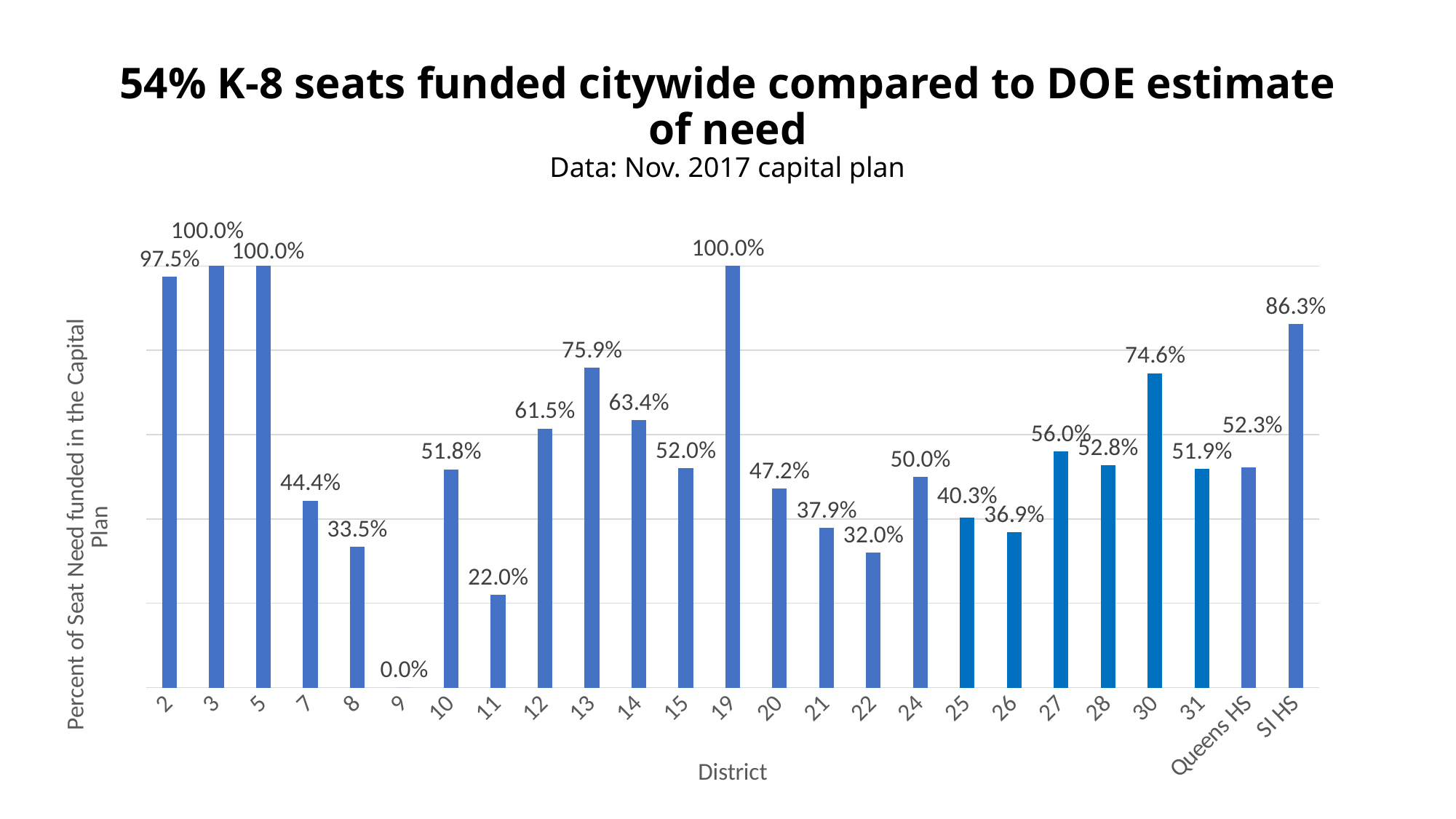
Which district has the lowest percent of seat need funded? 9 What is the difference between the values for district 12 and district 11? 39.5 percentage points What is the value for SI HS? 86.3% What is the label of the x axis? District What is the value for Queens HS? 52.3% What is the value for district 11? 22.0% Which has a higher value, district 14 or district 12? District 14 How many categories are shown on the x axis? 25 What kind of chart is shown on the slide? Bar chart What is the difference between the values for district 2 and SI HS? 11.2 percentage points What is the value for district 13? 75.9% Which has a higher value, district 27 or district 28? District 27